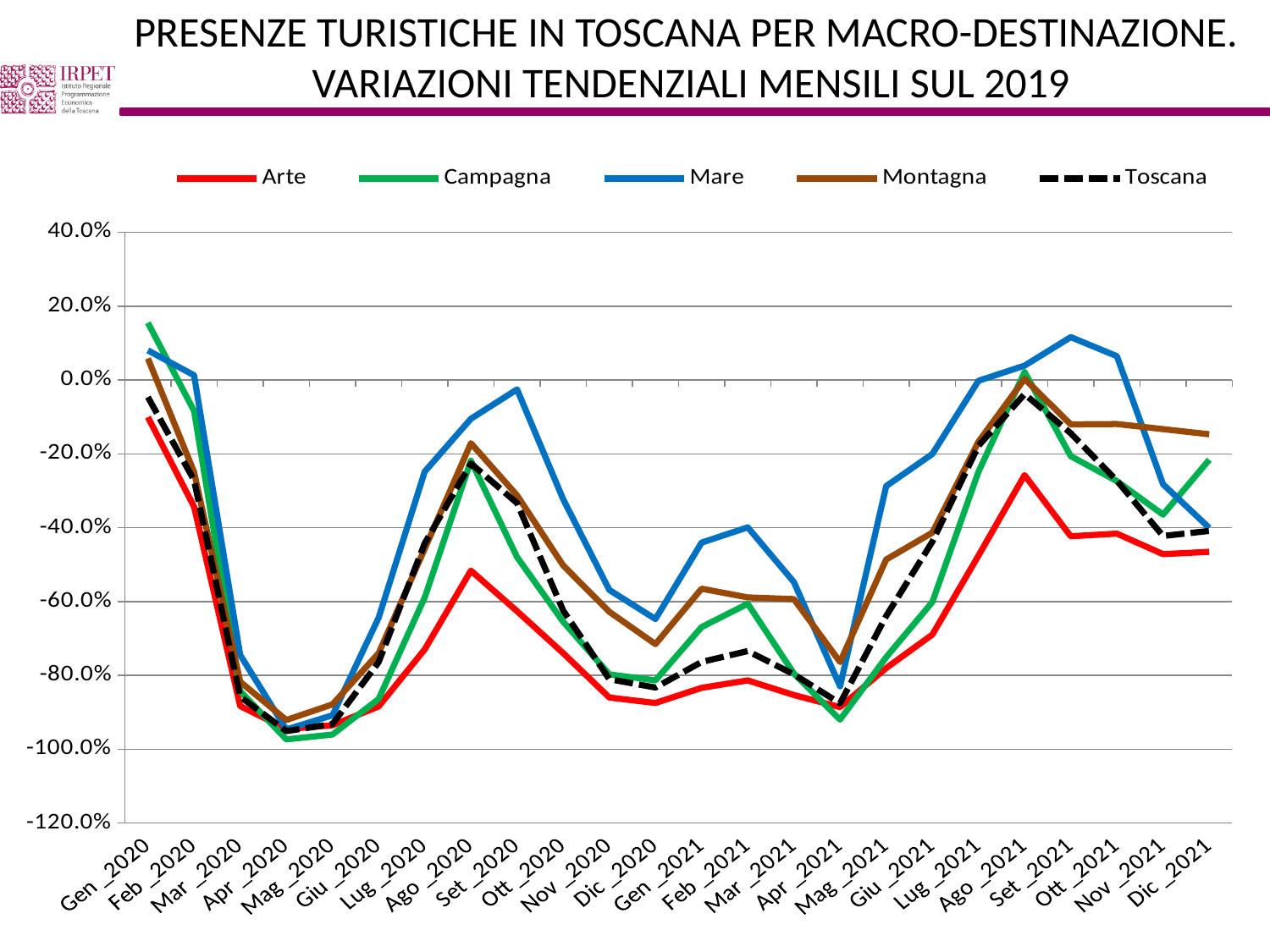
What kind of chart is shown on the slide? line chart Which series has the highest value in Set_2021? Mare How many months are plotted along the x axis? 24 Does the Mare line rise or fall from Set_2021 to Dic_2021? fall In Gen_2020, which is larger, the value for Campagna or the value for Arte? Campagna Which series is drawn with a dashed line? Toscana In Set_2021, which is larger, the value for Mare or the value for Arte? Mare How many series does the legend list? 5 Is the value for Mare in Set_2020 greater or less than -20.0%? greater Is the value for Montagna in Dic_2021 greater or less than -20.0%? greater Is the value for Arte in Apr_2020 greater or less than -80.0%? less Which series has the lowest value in Ago_2020? Arte